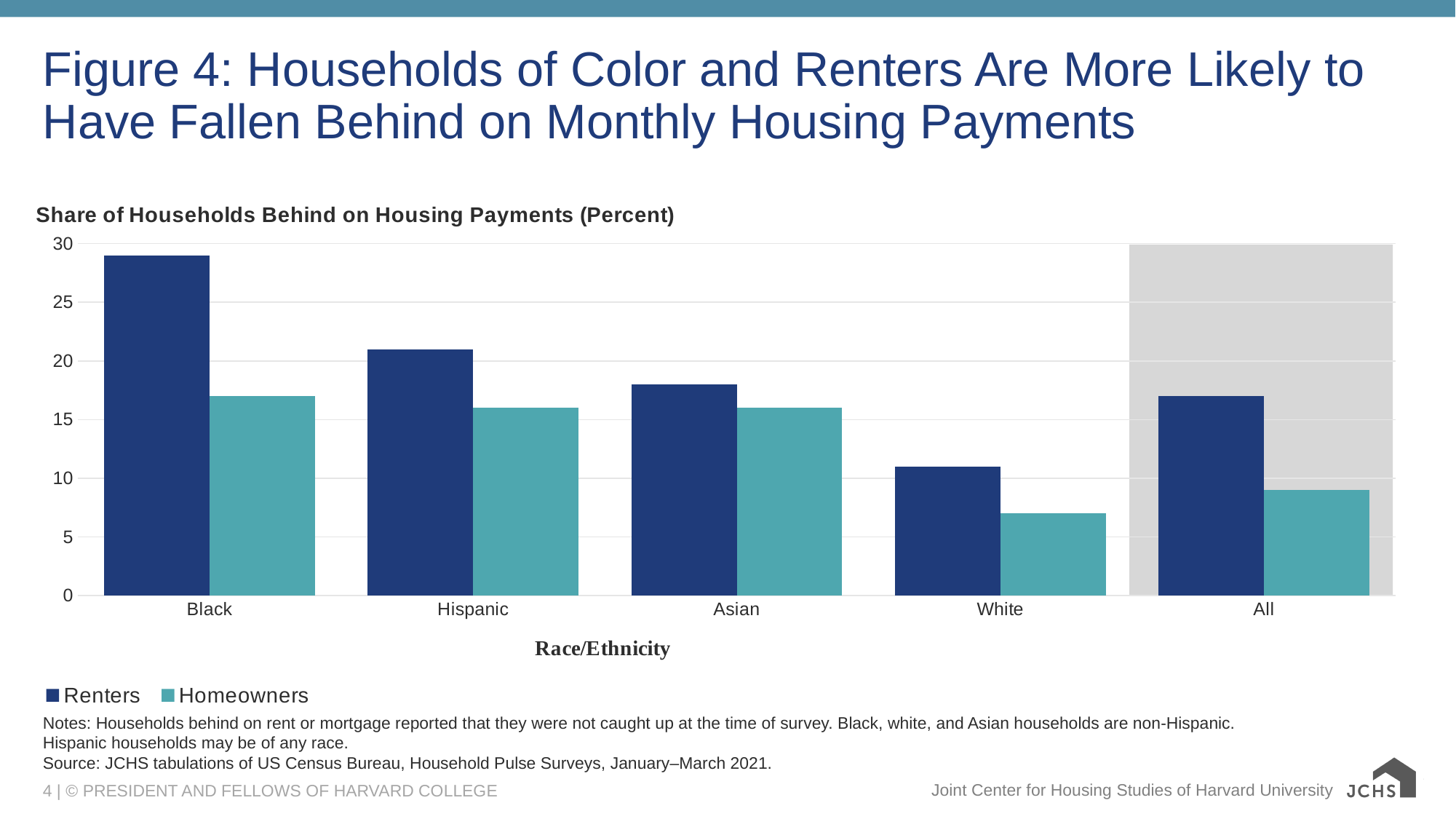
Is the Homeowners value for Asian households greater or less than 15? greater How many race/ethnicity categories are shown on the x axis? 5 How many series does the legend list? 2 What is the title of the x axis? Race/Ethnicity Which race/ethnicity category has the lowest value for Renters? White Which race/ethnicity category has the highest value for Renters? Black Which is larger, the Renters value for Hispanic households or the Renters value for White households? Hispanic Which is larger for Black households, the Renters value or the Homeowners value? Renters Is the Renters value for Black households greater or less than 25? greater Is the Homeowners value for All households greater or less than 10? less Which race/ethnicity category has the lowest value for Homeowners? White What kind of chart is shown on the slide? bar chart